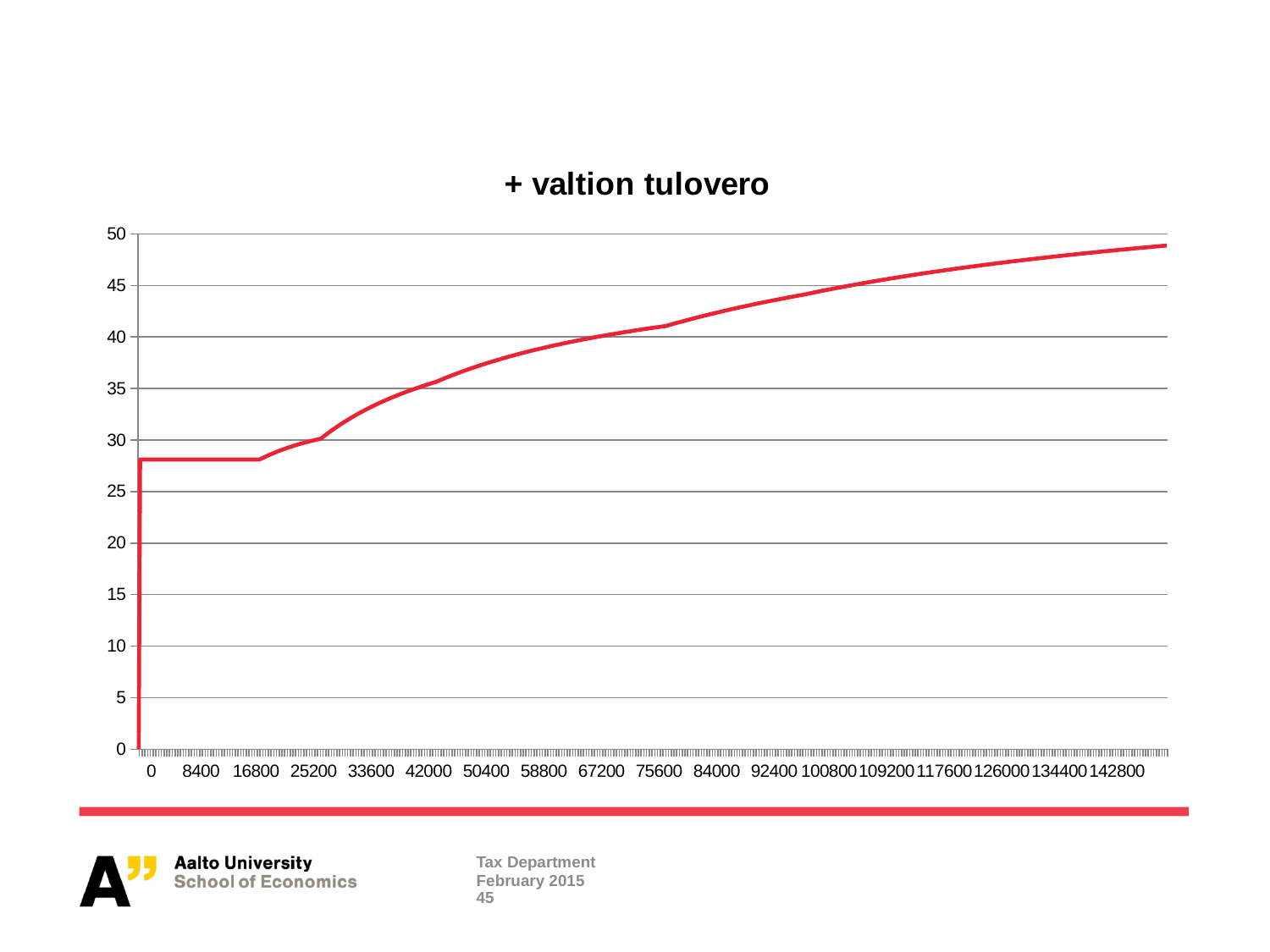
What colour is the plotted line? red Does the line generally rise or fall as the x-axis values increase from 16800 to 142800? rise What kind of chart is shown on the slide? line chart Is the value of the line at x = 42000 greater or less than 30? greater What is the highest value labelled on the y axis? 50 Is the value of the line at x = 58800 greater or less than 35? greater Is the value of the line at x = 142800 greater or less than 50? less What is the title of the chart? + valtion tulovero Which is larger, the value of the line at x = 142800 or at x = 8400? 142800 How many labelled tick values are shown on the x axis? 18